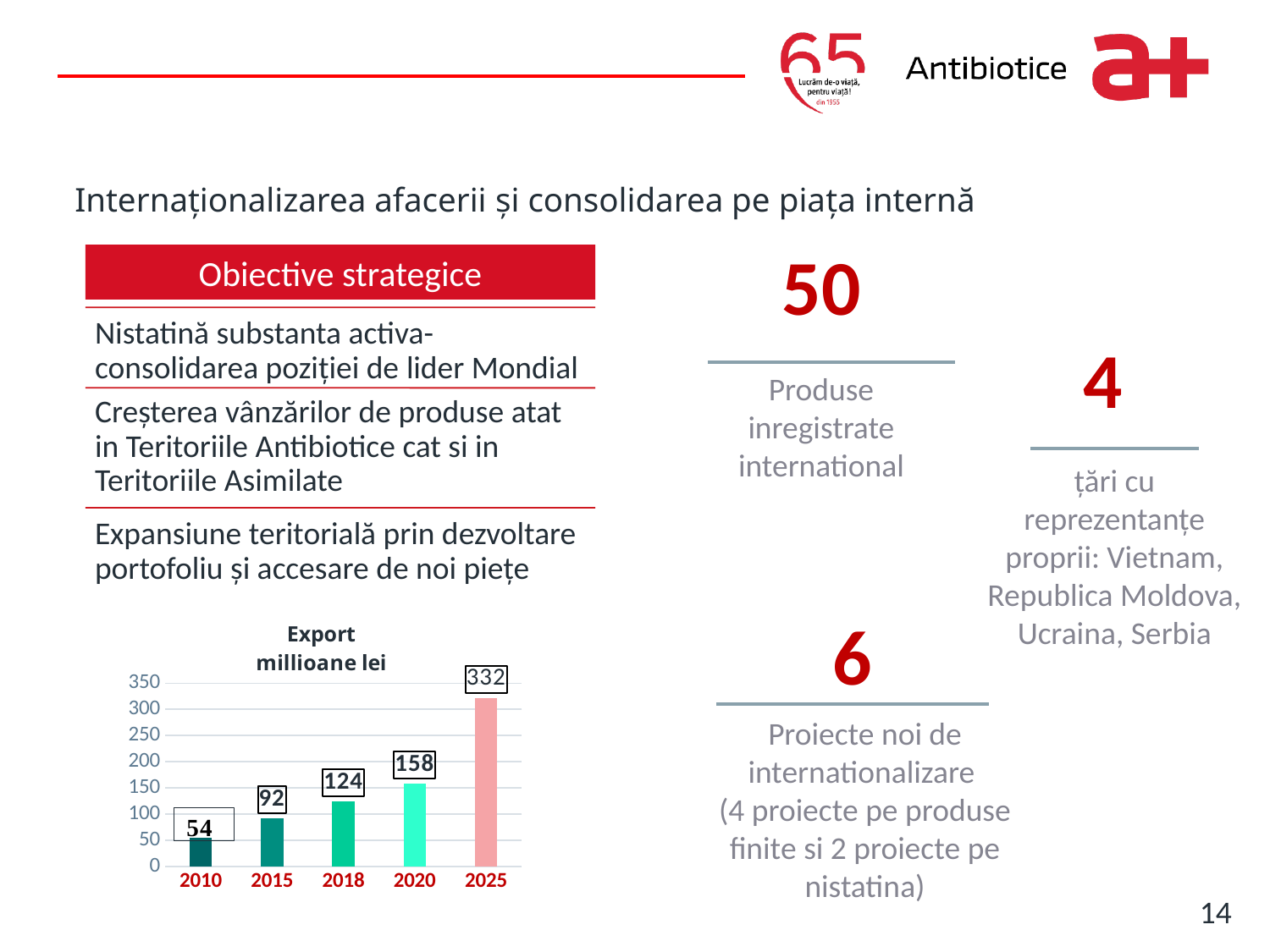
Do the export values rise or fall from 2010 to 2025? rise How many years are shown on the export chart? 5 What kind of chart is the export chart? bar chart Which year has the highest export value? 2025 What unit is given in the title of the export chart? millioane lei Which year has the lowest export value? 2010 What is the difference between the export values for 2020 and 2015? 66 What is the export value shown for 2018? 124 Is the export value for 2025 greater or less than 300? greater What is the export value shown for 2010? 54 What is the export value shown for 2025? 332 Which is larger, the export value for 2018 or for 2020? 2020